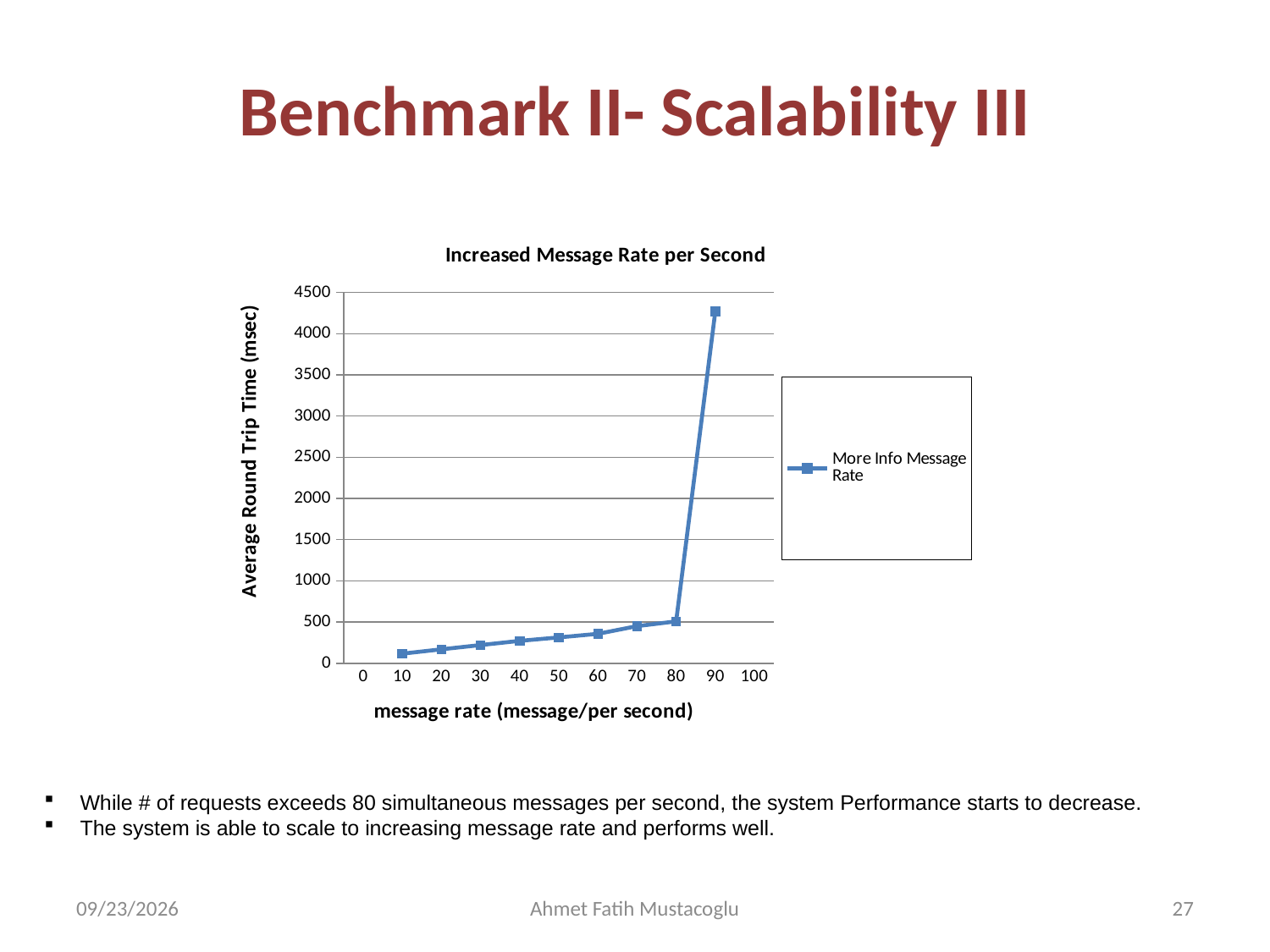
What is the title of the chart? Increased Message Rate per Second Do the values rise or fall as the message rate increases along the x axis? rise How many data points are plotted on the line? 9 What is the name of the series shown in the legend? More Info Message Rate At which message rate is the average round trip time lowest? 10 Is the average round trip time at a message rate of 80 greater or less than 1000? less What kind of chart is shown on the slide? line chart Is the average round trip time at a message rate of 50 greater or less than 500? less How many series does the legend list? 1 Which has a larger average round trip time: a message rate of 90 or a message rate of 80? 90 At which message rate is the average round trip time highest? 90 Is the average round trip time at a message rate of 90 greater or less than 4000? greater